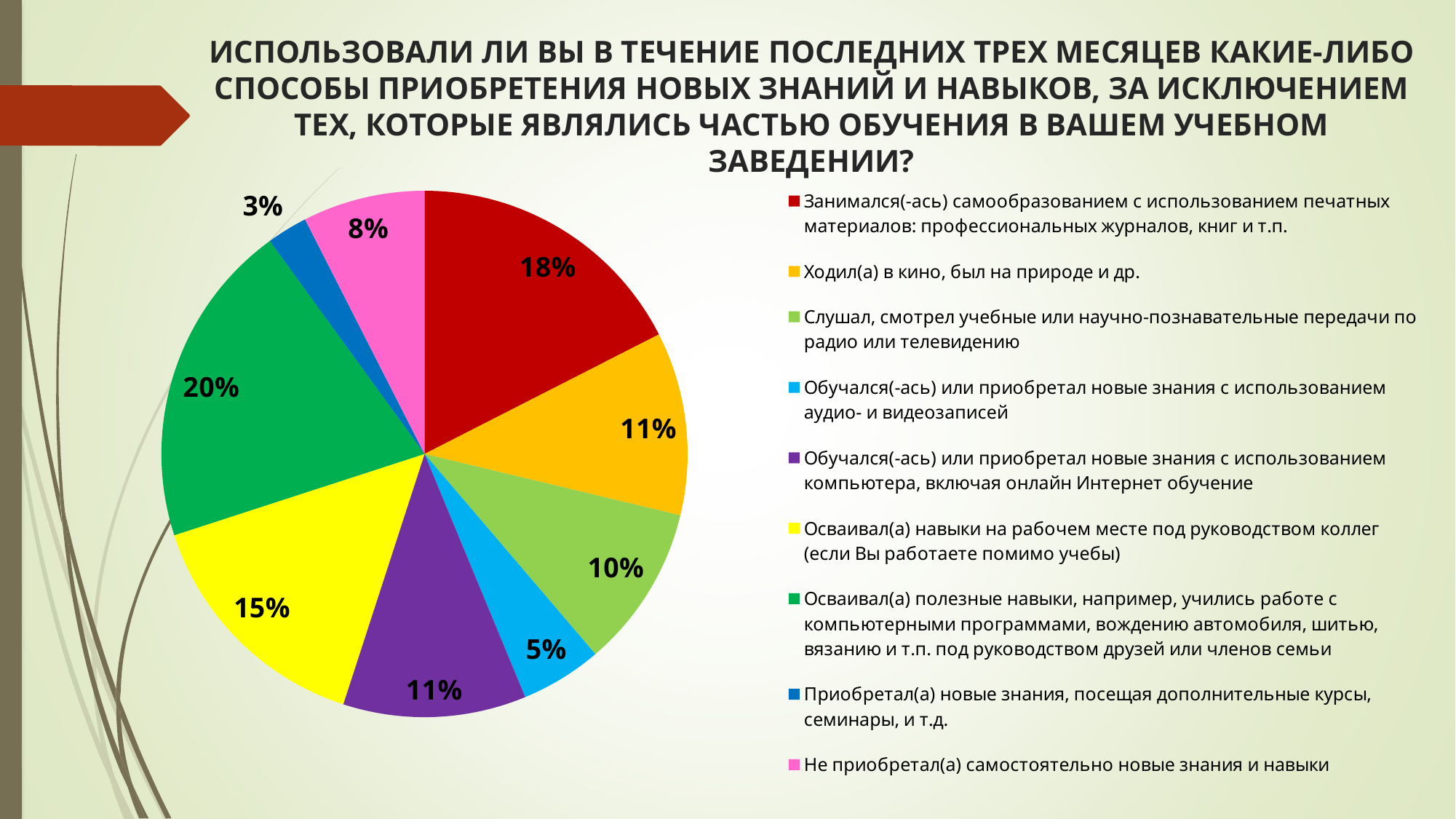
Which is larger: the slice for "Обучался(-ась) или приобретал новые знания с использованием компьютера, включая онлайн Интернет обучение" or the slice for "Не приобретал(а) самостоятельно новые знания и навыки"? Обучался(-ась) или приобретал новые знания с использованием компьютера, включая онлайн Интернет обучение What share of the pie is labelled for "Занимался(-ась) самообразованием с использованием печатных материалов: профессиональных журналов, книг и т.п."? 18% Which category has the largest slice of the pie? Осваивал(а) полезные навыки, например, учились работе с компьютерными программами, вождению автомобиля, шитью, вязанию и т.п. под руководством друзей или членов семьи What percentage is shown for "Обучался(-ась) или приобретал новые знания с использованием аудио- и видеозаписей"? 5% Which category has the smallest slice of the pie? Приобретал(а) новые знания, посещая дополнительные курсы, семинары, и т.д. What percentage is shown for "Ходил(а) в кино, был на природе и др."? 11% What is the difference in percentage points between "Осваивал(а) навыки на рабочем месте под руководством коллег (если Вы работаете помимо учебы)" and "Слушал, смотрел учебные или научно-познавательные передачи по радио или телевидению"? 5 What is the combined share of the two slices labelled 18% and 20%? 38% What percentage is shown for "Не приобретал(а) самостоятельно новые знания и навыки"? 8% How many slices does the pie chart have? 9 What colour is the slice for "Осваивал(а) навыки на рабочем месте под руководством коллег (если Вы работаете помимо учебы)"? yellow What type of chart is shown on the slide? pie chart